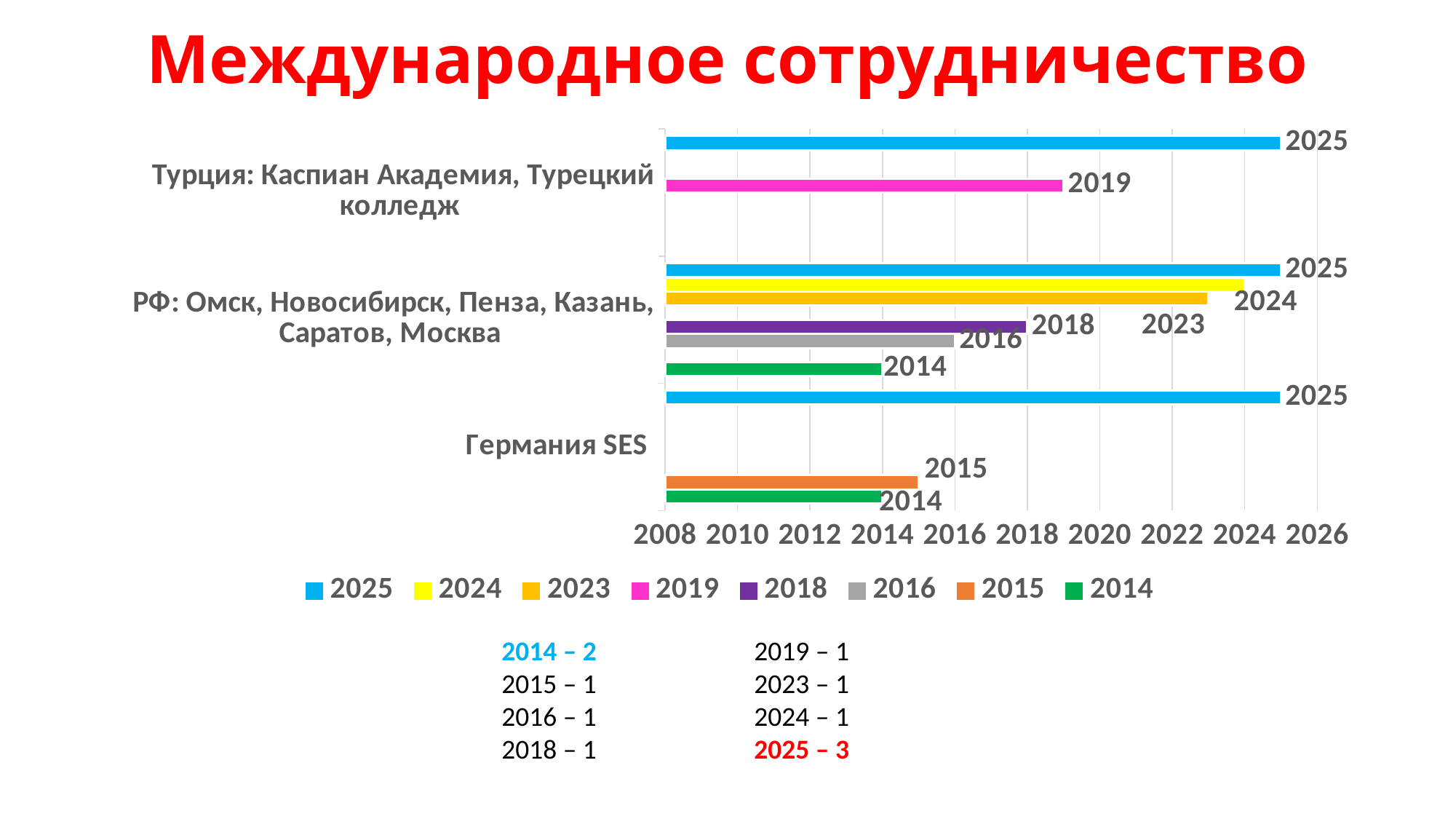
What kind of chart is shown on the slide? bar chart How many bars are plotted for the category 'РФ: Омск, Новосибирск, Пенза, Казань, Саратов, Москва'? 6 How many bars are plotted for the category 'Германия SES'? 3 Which series has the longest bar for 'РФ: Омск, Новосибирск, Пенза, Казань, Саратов, Москва'? 2025 What is the title of the slide containing the chart? Международное сотрудничество How many categories are shown on the vertical axis of the chart? 3 What value is labelled on the 2015 bar for 'Германия SES'? 2015 How many series does the chart legend list? 8 What is the difference between the 2025 bar value and the 2014 bar value for 'РФ: Омск, Новосибирск, Пенза, Казань, Саратов, Москва'? 11 Which series has the shortest bar for 'РФ: Омск, Новосибирск, Пенза, Казань, Саратов, Москва'? 2014 For 'Турция: Каспиан Академия, Турецкий колледж', which bar is longer, the 2025 bar or the 2019 bar? 2025 What value is labelled on the 2019 bar for 'Турция: Каспиан Академия, Турецкий колледж'? 2019